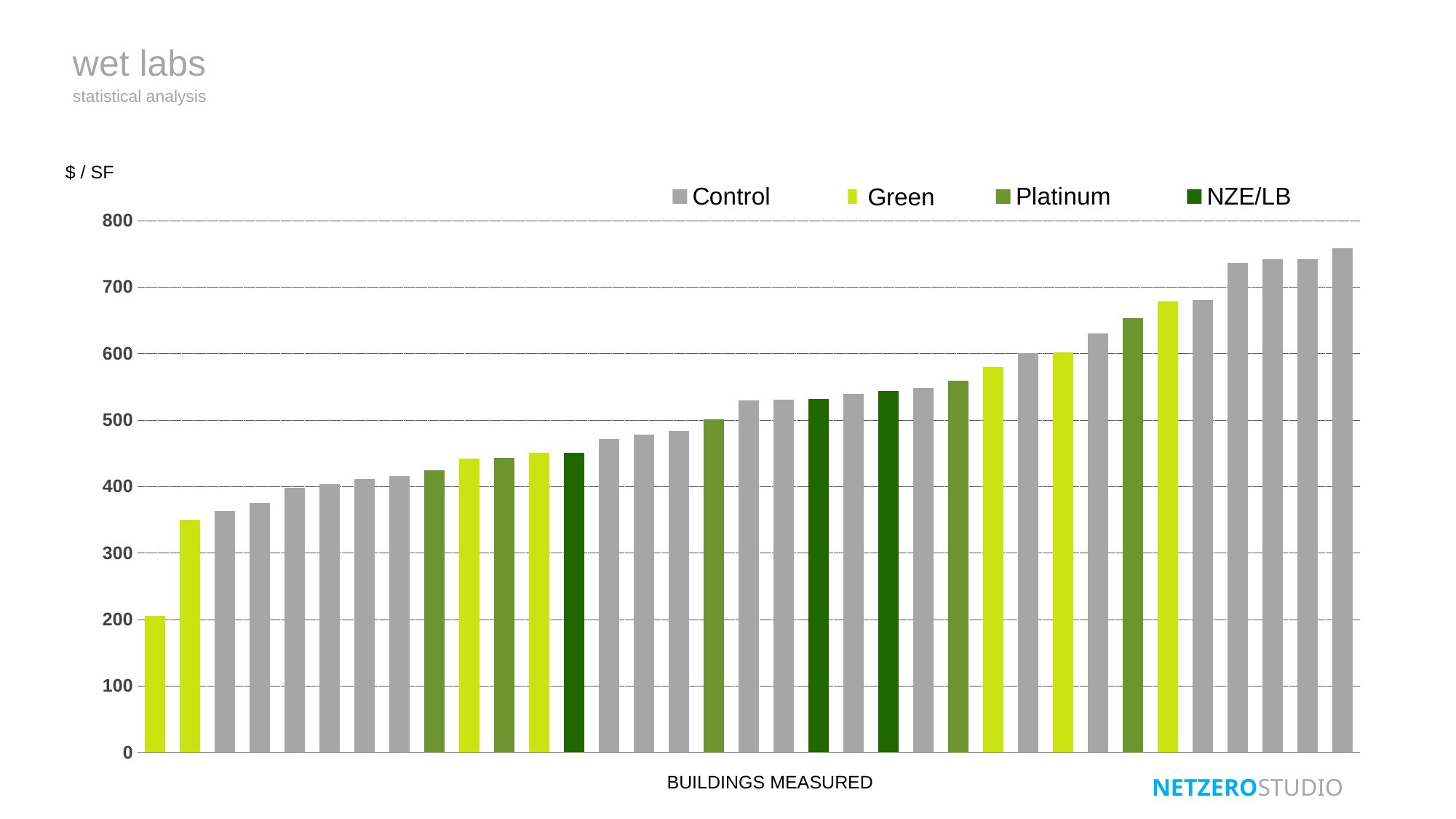
What kind of chart is shown on the slide? bar chart How many series does the legend list? 4 Is the value of the rightmost bar greater or less than 700? greater Which series does the tallest bar in the chart belong to? Control Do the bar values rise or fall from left to right along the x axis? rise What are the four series named in the legend? Control, Green, Platinum, NZE/LB How many bars belong to the NZE/LB series? 3 Which series does the shortest bar in the chart belong to? Green What is the label on the vertical axis of the chart? $ / SF Is the value of the leftmost bar greater or less than 300? less How many bars are plotted in the chart? 35 Is the value of the second bar from the left greater or less than 400? less